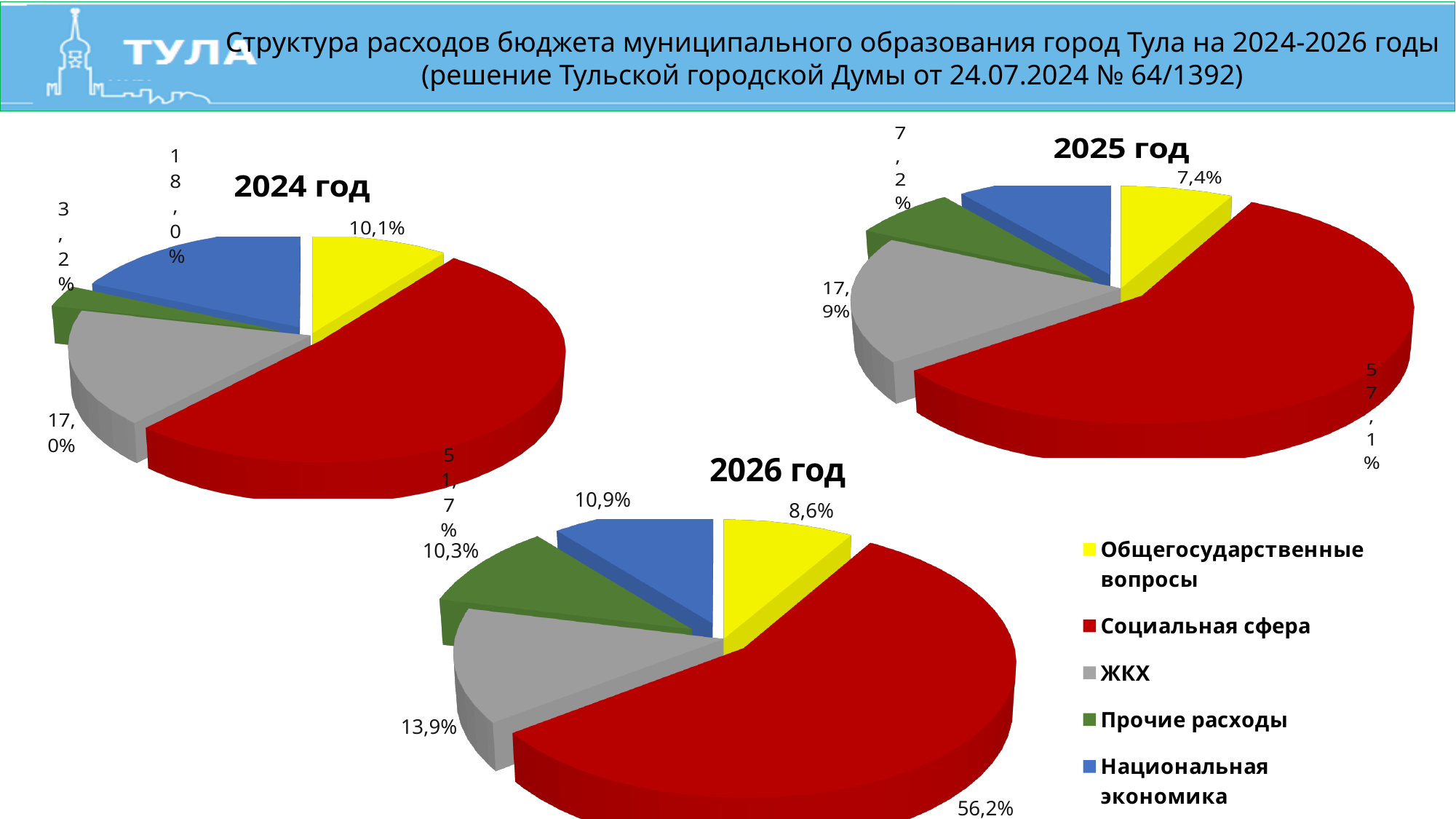
On the 2024 год pie chart, what share is shown for Национальная экономика? 18,0% On the 2026 год pie chart, which is larger: the share of Национальная экономика or the share of Общегосударственные вопросы? Национальная экономика On the 2024 год pie chart, which category has the smallest share? Прочие расходы On the 2025 год pie chart, what share is shown for Социальная сфера? 57,1% How many series does the legend list? 5 On the 2024 год pie chart, what share is shown for Прочие расходы? 3,2% What kind of chart is used for each year on the slide? Pie chart On the 2026 год pie chart, which category has the largest share? Социальная сфера On the 2026 год pie chart, what is the difference between the shares of ЖКХ and Прочие расходы? 3,6% On the 2026 год pie chart, what share is shown for Общегосударственные вопросы? 8,6% On the 2025 год pie chart, what share is shown for ЖКХ? 17,9% On the 2024 год pie chart, what share is shown for Социальная сфера? 51,7%